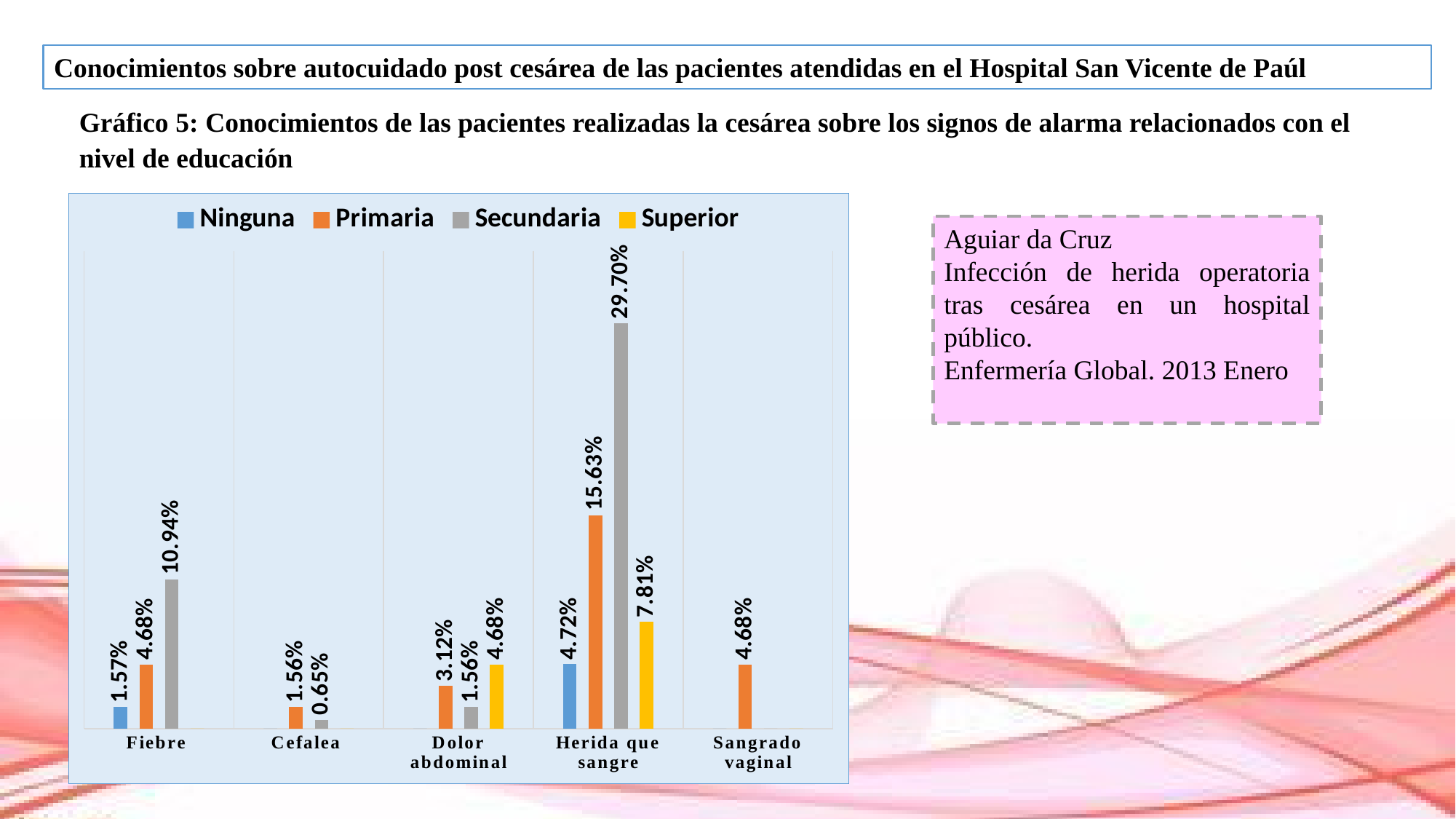
What is the value for Ninguna in the Herida que sangre category? 4.72% Which category has the highest value for the Secundaria series? Herida que sangre What is the value for Superior in the Dolor abdominal category? 4.68% In the Fiebre category, what is the difference between the Secundaria and Ninguna values? 9.37% In the Herida que sangre category, what is the difference between the Secundaria and Primaria values? 14.07% Which is larger: the Secundaria value for Fiebre or the Superior value for Herida que sangre? Secundaria value for Fiebre How many categories are shown on the x axis of the chart? 5 How many series does the chart legend list? 4 What kind of chart is shown on the slide? Bar chart What is the value for Primaria in the Fiebre category? 4.68% What is the value for Secundaria in the Herida que sangre category? 29.70%